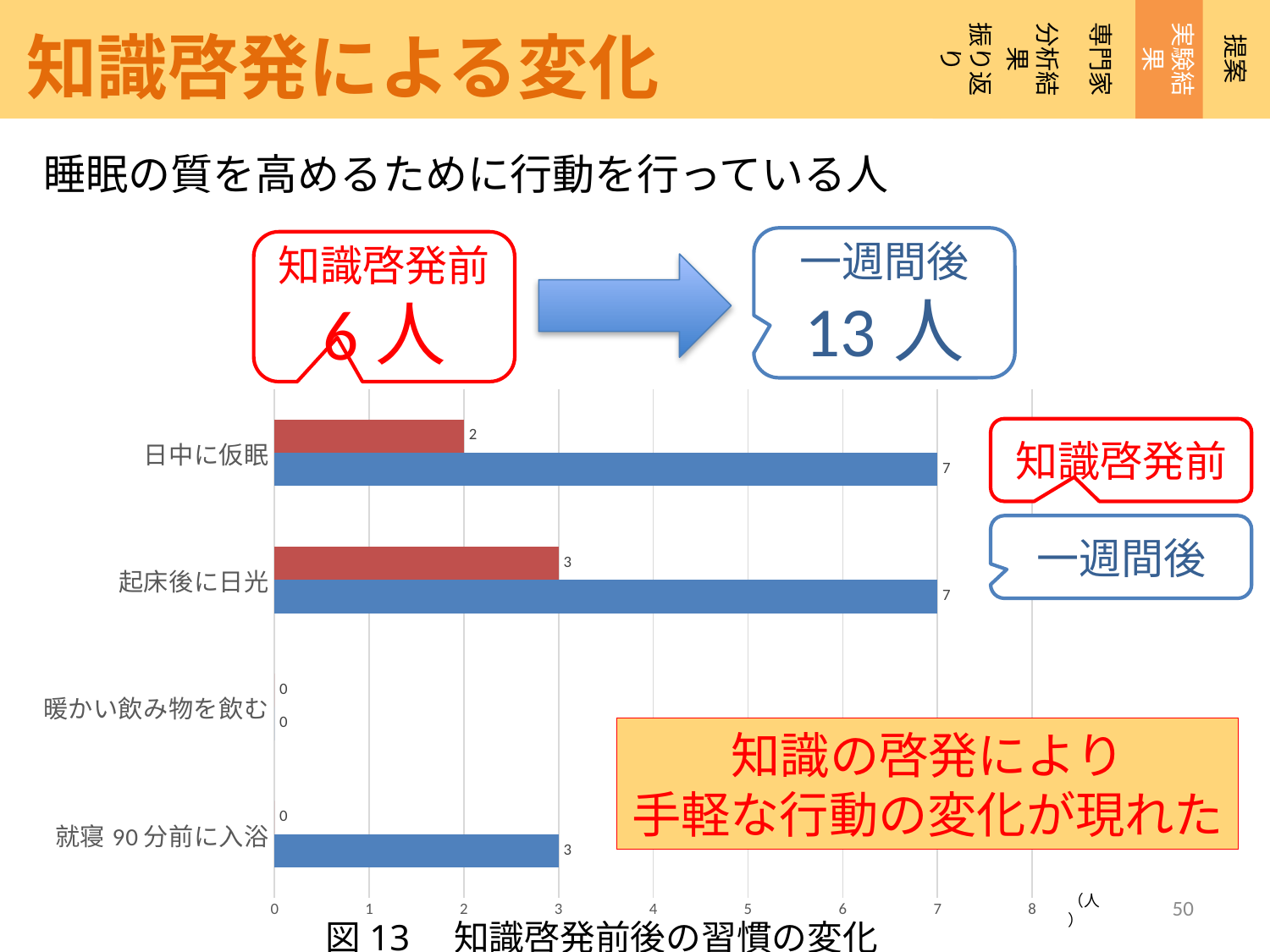
「就寝90分前に入浴」の一週間後の値はいくつですか？ 3 このグラフには系列がいくつありますか？ 2 「日中に仮眠」の一週間後の値はいくつですか？ 7 一週間後の系列で最も値が小さい項目はどれですか？ 暖かい飲み物を飲む 「日中に仮眠」の一週間後と知識啓発前の値の差はいくつですか？ 5 このグラフには項目（カテゴリ）がいくつありますか？ 4 「日中に仮眠」の知識啓発前と「就寝90分前に入浴」の一週間後では、どちらの値が大きいですか？ 就寝90分前に入浴の一週間後 知識啓発前の系列で最も値が大きい項目はどれですか？ 起床後に日光 「起床後に日光」の一週間後と知識啓発前の値の差はいくつですか？ 4 「暖かい飲み物を飲む」の知識啓発前の値はいくつですか？ 0 このグラフはどの種類のグラフですか？ 棒グラフ 「起床後に日光」の知識啓発前の値はいくつですか？ 3